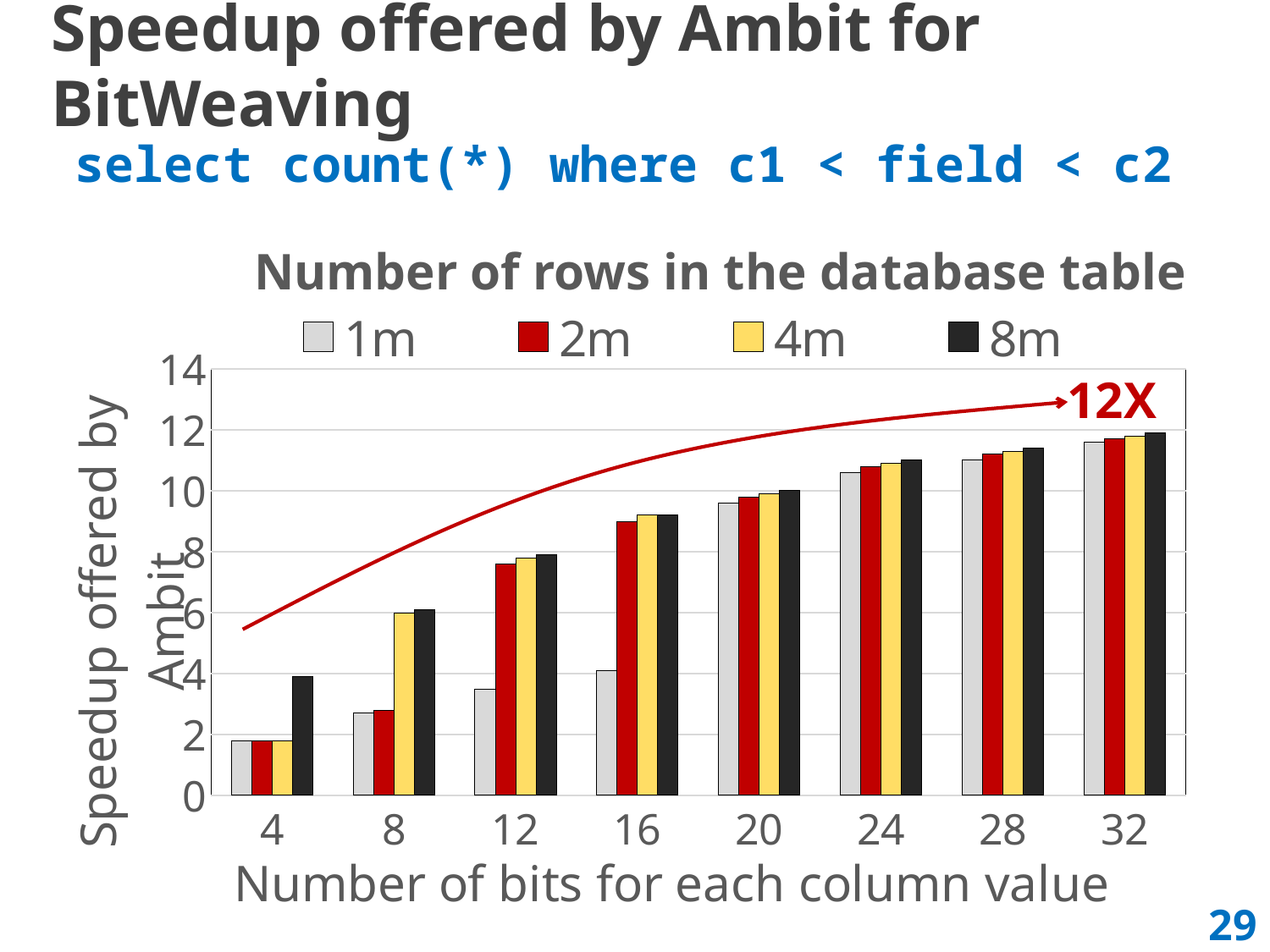
For the 8m series, at which number of bits is the speedup highest? 32 How many series does the legend list? 4 Is the speedup for 1m rows at 12 bits greater or less than 4? less Is the speedup for 1m rows at 20 bits greater or less than 10? less What kind of chart is shown on the slide? bar chart Do the speedup values rise or fall as the number of bits for each column value increases? rise At 4 bits, which is larger: the speedup for 1m rows or for 8m rows? 8m Is the speedup for 8m rows at 32 bits greater or less than 10? greater How many categories are shown on the x axis (number of bits for each column value)? 8 What is the label of the x axis? Number of bits for each column value At 8 bits, which is larger: the speedup for 1m rows or for 4m rows? 4m